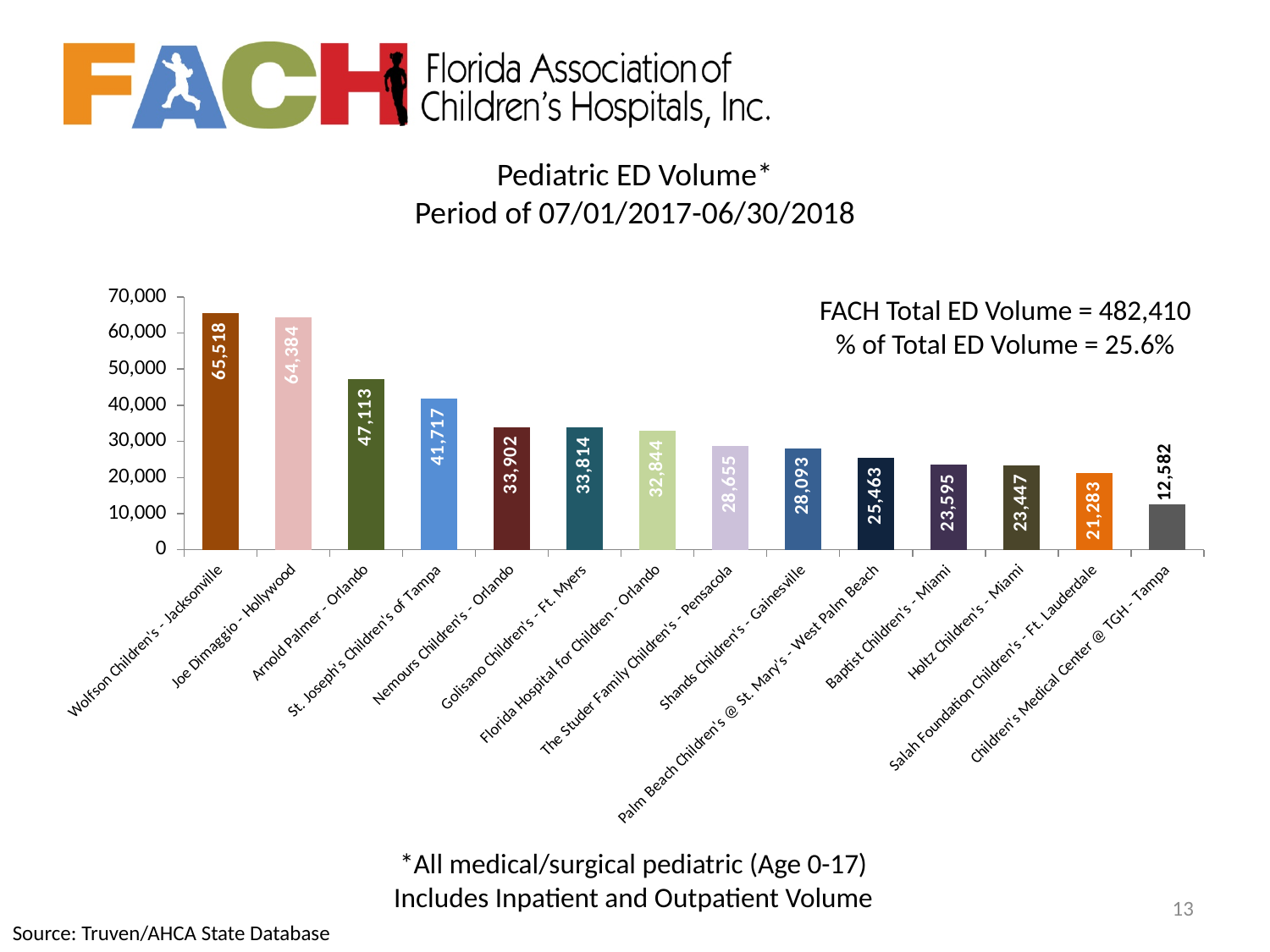
Which hospital has the highest pediatric ED volume? Wolfson Children's - Jacksonville What is the pediatric ED volume for Shands Children's - Gainesville? 28,093 What is the difference in pediatric ED volume between Wolfson Children's - Jacksonville and Joe DiMaggio - Hollywood? 1,134 What is the pediatric ED volume for Salah Foundation Children's - Ft. Lauderdale? 21,283 What kind of chart is used to show pediatric ED volume? Bar chart What is the difference in pediatric ED volume between Arnold Palmer - Orlando and St. Joseph's Children's of Tampa? 5,396 Is the pediatric ED volume for Baptist Children's - Miami greater or less than 30,000? less How many hospitals are shown in the chart? 14 What is the FACH Total ED Volume stated on the chart? 482,410 Which has a larger pediatric ED volume, Arnold Palmer - Orlando or St. Joseph's Children's of Tampa? Arnold Palmer - Orlando What is the pediatric ED volume for Wolfson Children's - Jacksonville? 65,518 Which hospital has the lowest pediatric ED volume? Children's Medical Center @ TGH - Tampa